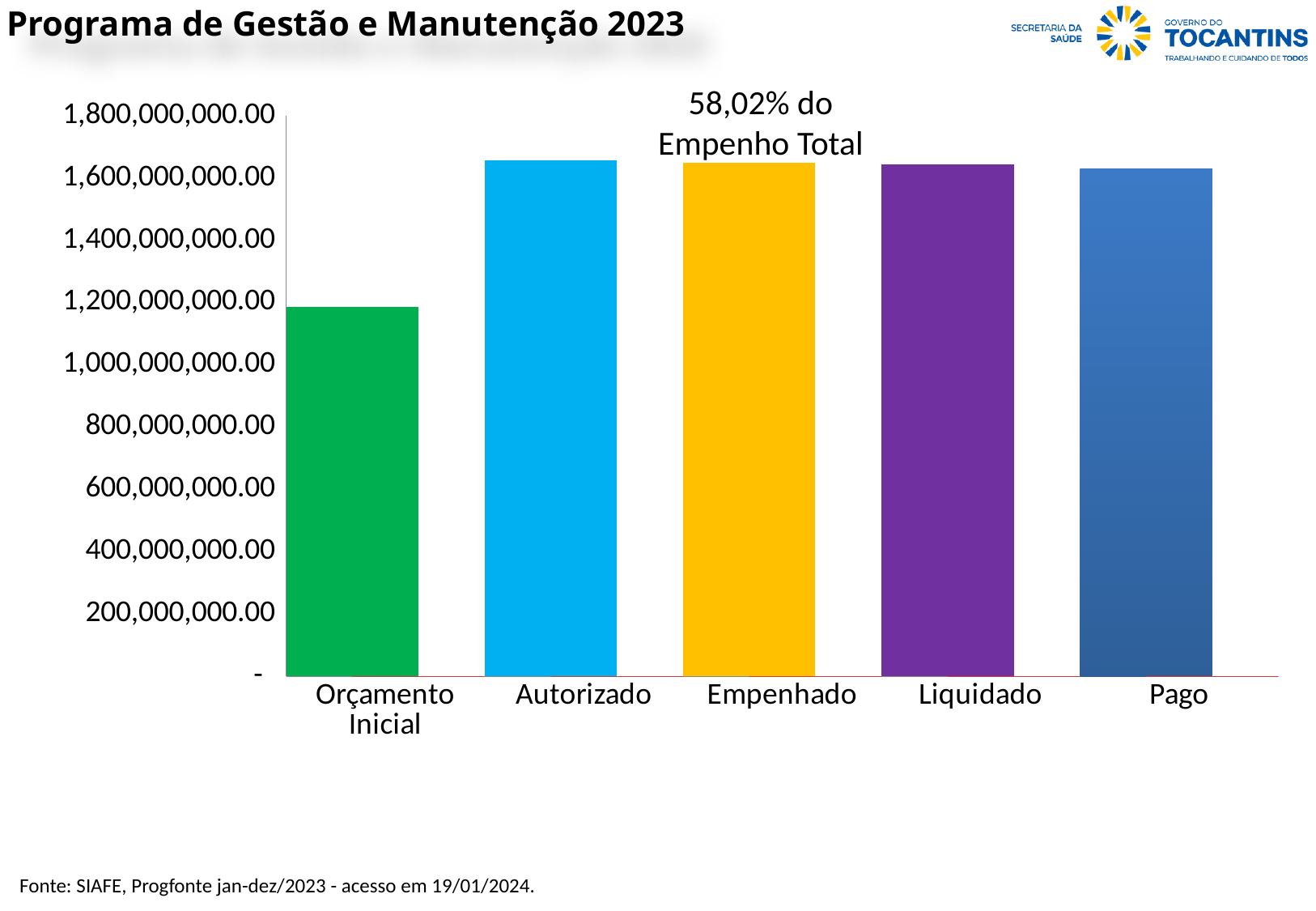
Is the value for Pago greater or less than 1,800,000,000.00? less Is the value for Autorizado greater or less than 1,600,000,000.00? greater Is the value for Orçamento Inicial greater or less than 1,000,000,000.00? greater Which is larger, the value for Orçamento Inicial or the value for Autorizado? Autorizado How many categories are shown on the x axis of the chart? 5 Which category has the lowest value in the chart? Orçamento Inicial What is the title of the slide containing the chart? Programa de Gestão e Manutenção 2023 Which is larger, the value for Pago or the value for Orçamento Inicial? Pago What kind of chart is shown on the slide? Bar chart What text is annotated above the Empenhado bar? 58,02% do Empenho Total